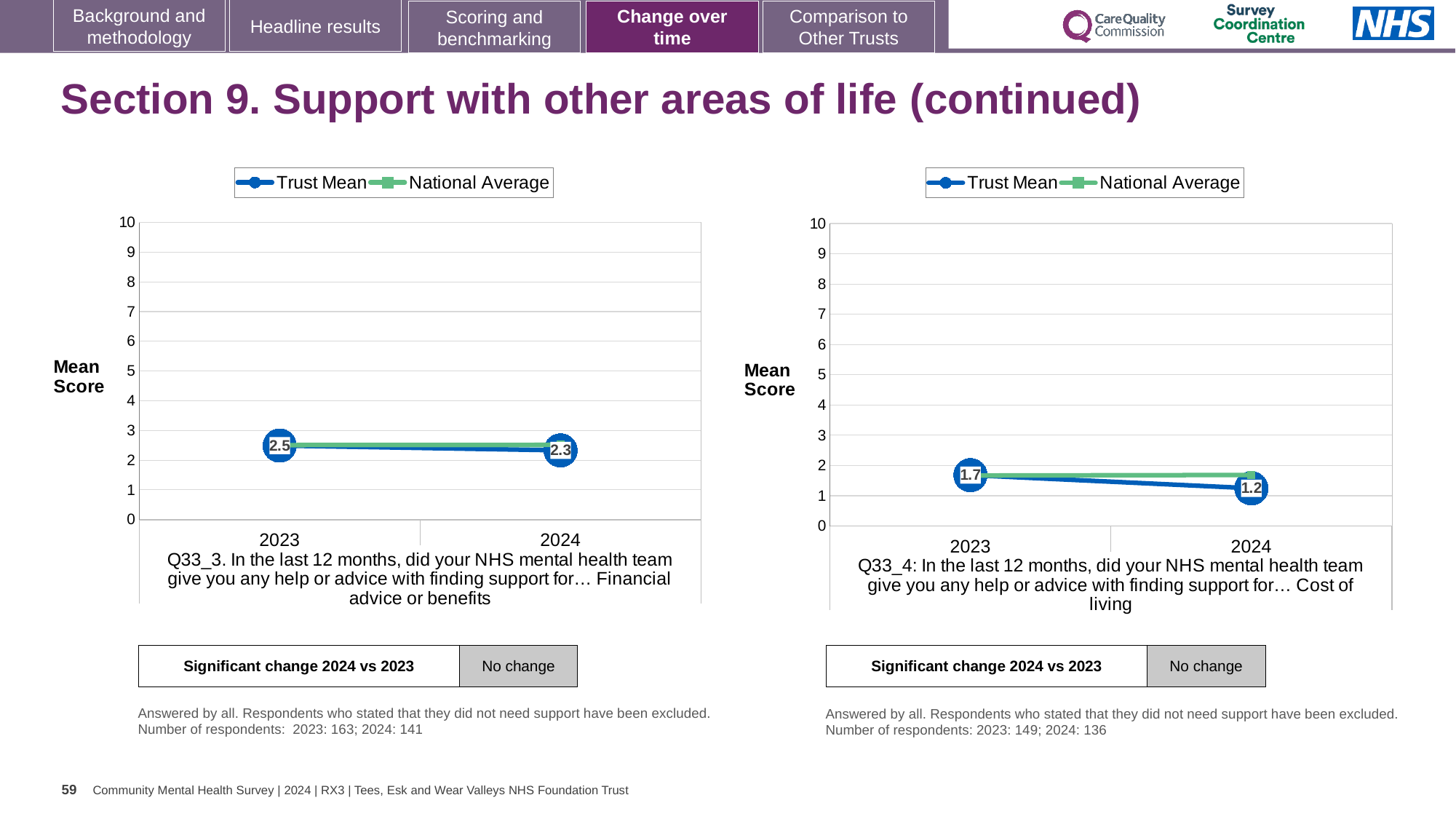
On the right chart (Q33_4, Cost of living), what is the Trust Mean for 2024? 1.2 On the left chart (Q33_3, Financial advice or benefits), what is the Trust Mean for 2023? 2.5 On the right chart (Q33_4), is the National Average for 2024 greater or less than 1? greater On the right chart (Q33_4), what is the difference between the Trust Mean in 2023 and 2024? 0.5 How many series does the legend of the left chart list? 2 What type of chart is used on the right side of the slide (Q33_4)? line chart On the right chart (Q33_4), does the Trust Mean rise or fall from 2023 to 2024? fall On the left chart (Q33_3, Financial advice or benefits), what is the Trust Mean for 2024? 2.3 How many years are plotted on the x axis of the left chart (Q33_3)? 2 On the right chart (Q33_4, Cost of living), what is the Trust Mean for 2023? 1.7 On the left chart (Q33_3), by how much did the Trust Mean change from 2023 to 2024? 0.2 On the left chart (Q33_3), is the Trust Mean for 2024 greater or less than 3? less